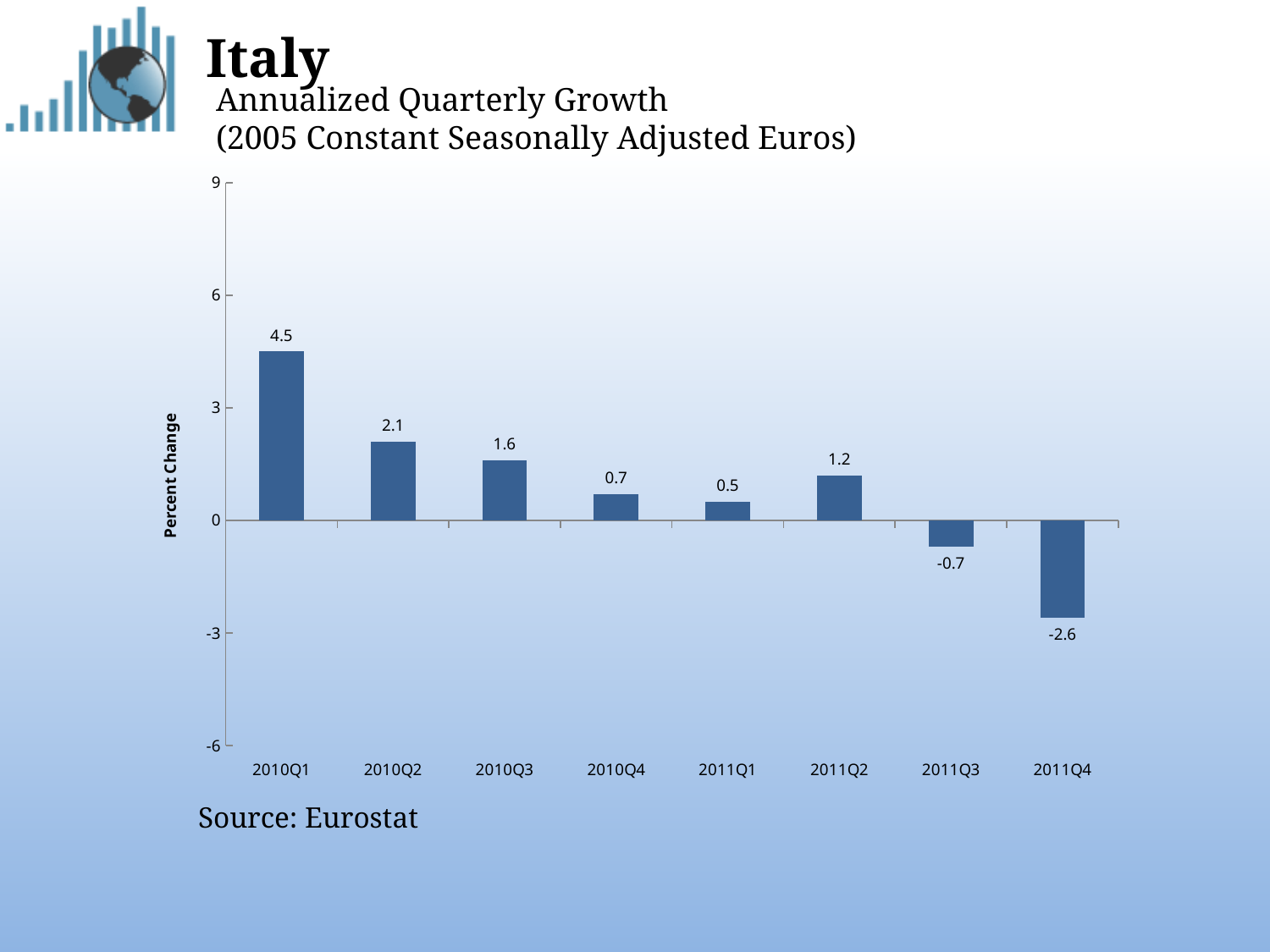
Which quarter has the highest annualized growth? 2010Q1 Which quarter has the lowest annualized growth? 2011Q4 What is the value shown for 2011Q2? 1.2 What is the value shown for 2011Q4? -2.6 How many quarters are shown on the x axis? 8 What kind of chart is shown on the slide? bar chart Which is larger, the value for 2010Q3 or the value for 2011Q2? 2010Q3 Is the value for 2010Q1 greater or less than 3? greater Do the values generally rise or fall from 2010Q1 to 2011Q4? fall What is the difference between the values for 2010Q1 and 2010Q2? 2.4 What is the label on the y axis? Percent Change What is the annualized quarterly growth value for 2010Q1? 4.5